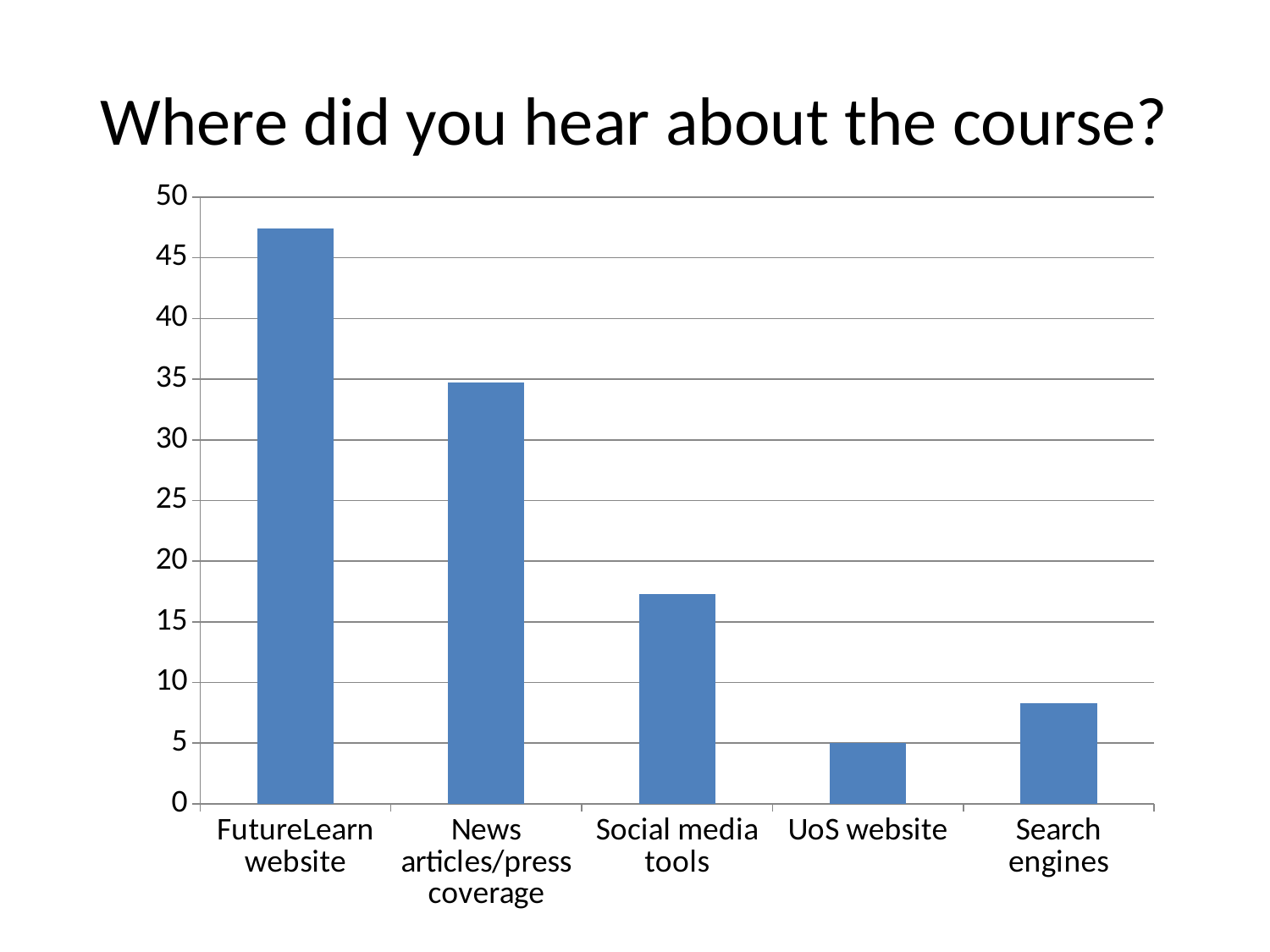
Is the value for FutureLearn website greater or less than 45? greater What is the title of the chart? Where did you hear about the course? What kind of chart is shown on the slide? bar chart Which is larger, the value for Social media tools or the value for Search engines? Social media tools Is the value for Search engines greater or less than 10? less Which is larger, the value for News articles/press coverage or the value for FutureLearn website? FutureLearn website Do the values rise or fall from FutureLearn website to UoS website along the x axis? fall Which category has the lowest bar? UoS website How many categories are shown on the x axis? 5 Is the value for News articles/press coverage greater or less than 30? greater Which category has the highest bar? FutureLearn website